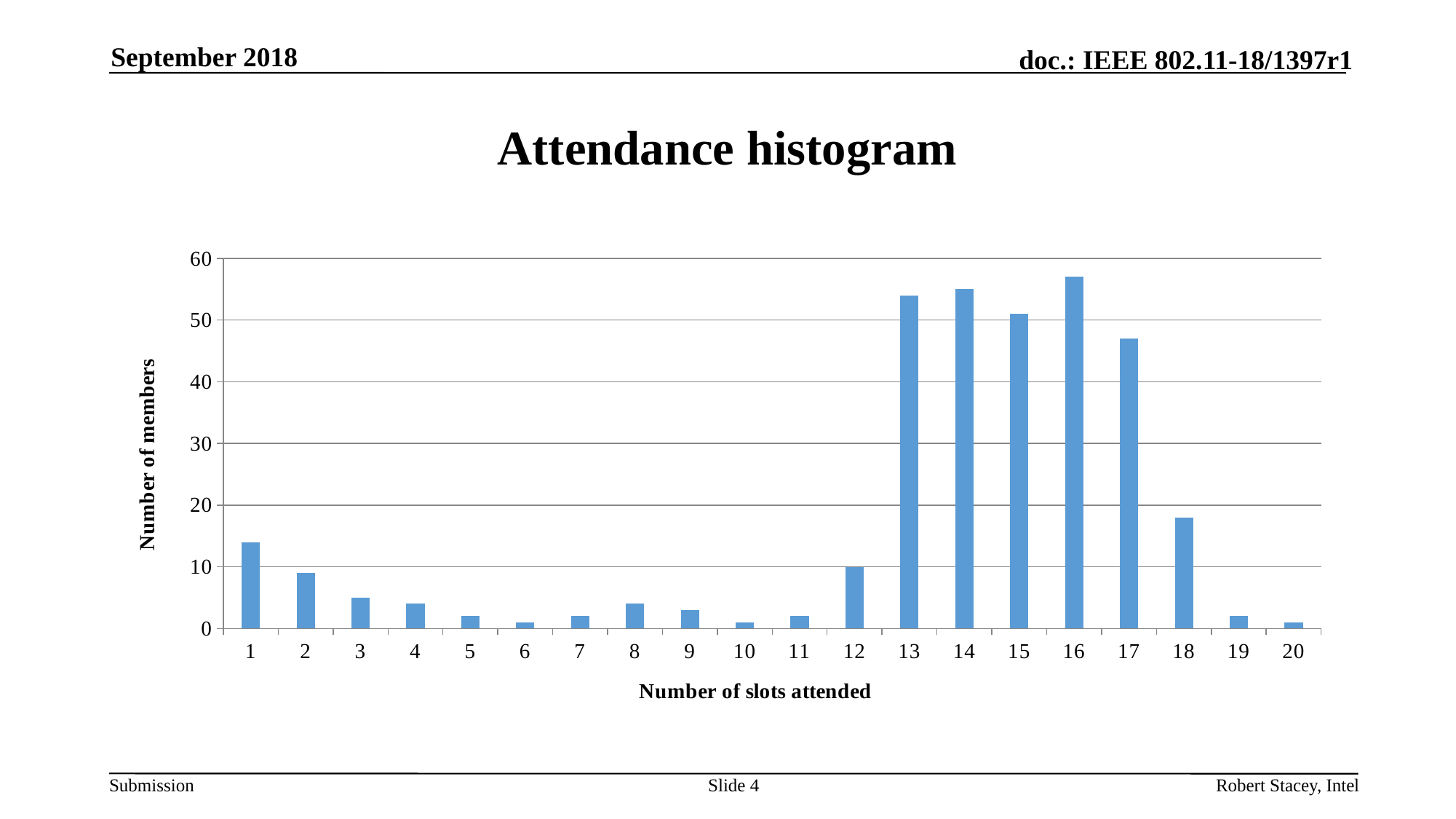
What kind of chart is shown on the slide? bar chart What is the title of the chart? Attendance histogram Is the value for 17 slots attended greater or less than 50? less Is the value for 1 slot attended greater or less than 10? greater What is the label of the y axis? Number of members Do the values rise or fall from 1 slot attended to 6 slots attended? fall Is the value for 18 slots attended greater or less than 20? less Do the values rise or fall from 16 slots attended to 20 slots attended? fall How many categories are shown on the x axis of the chart? 20 Which has more members: 13 slots attended or 18 slots attended? 13 slots attended Which has more members: 1 slot attended or 2 slots attended? 1 slot attended